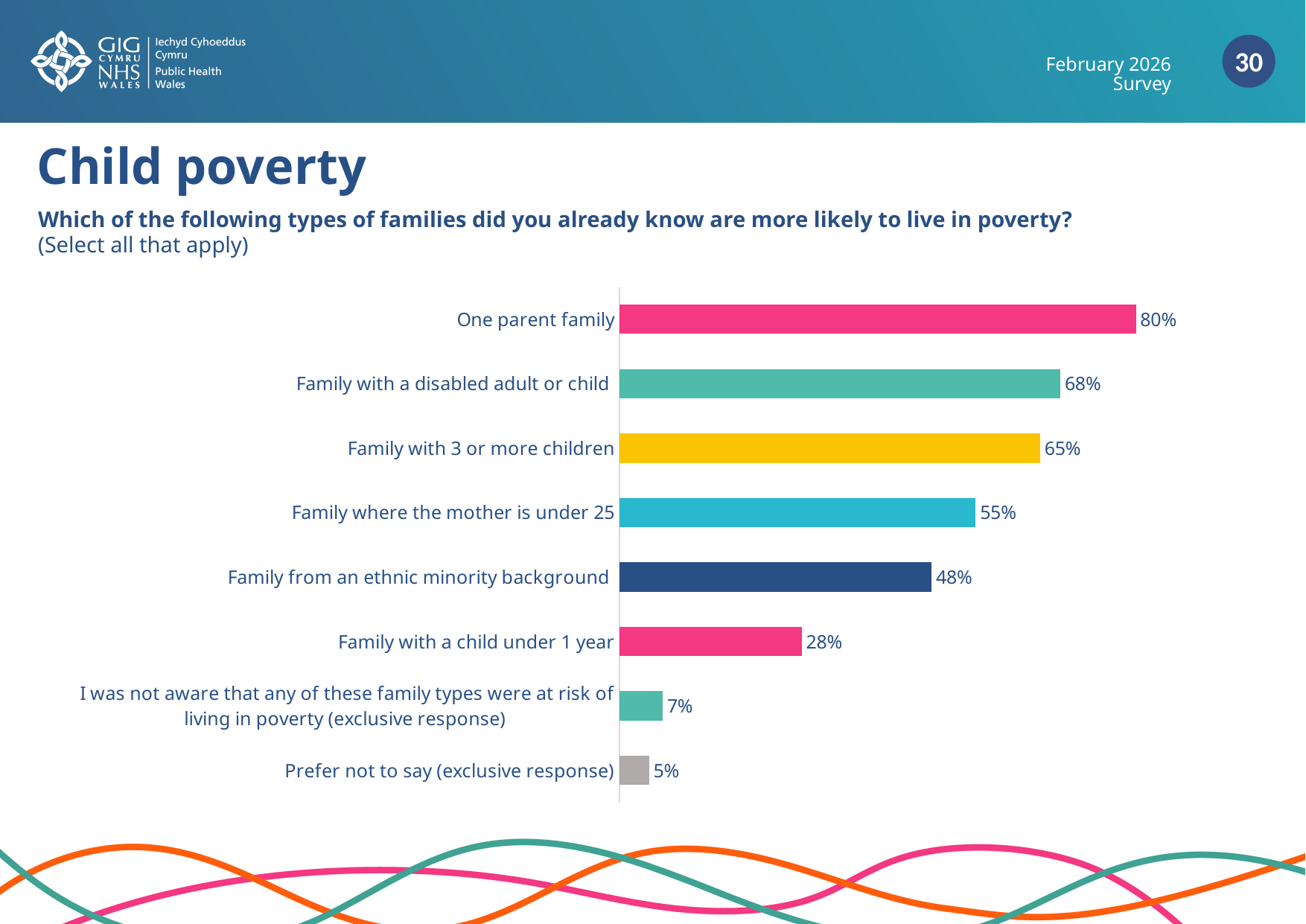
What percentage of respondents selected 'Family with a disabled adult or child'? 68% What percentage of respondents selected 'Family where the mother is under 25'? 55% Which family type has the highest percentage? One parent family Which has a higher percentage: 'Family with a disabled adult or child' or 'Family with 3 or more children'? Family with a disabled adult or child What is the difference in percentage points between 'One parent family' and 'Family with a child under 1 year'? 52 What kind of chart is shown on the slide? Bar chart What percentage of respondents selected 'Prefer not to say (exclusive response)'? 5% How many response categories are shown in the chart? 8 Which response has the lowest percentage? Prefer not to say (exclusive response) What is the difference in percentage points between 'Family with 3 or more children' and 'Family from an ethnic minority background'? 17 What percentage of respondents selected 'One parent family'? 80% What is the title of the slide? Child poverty